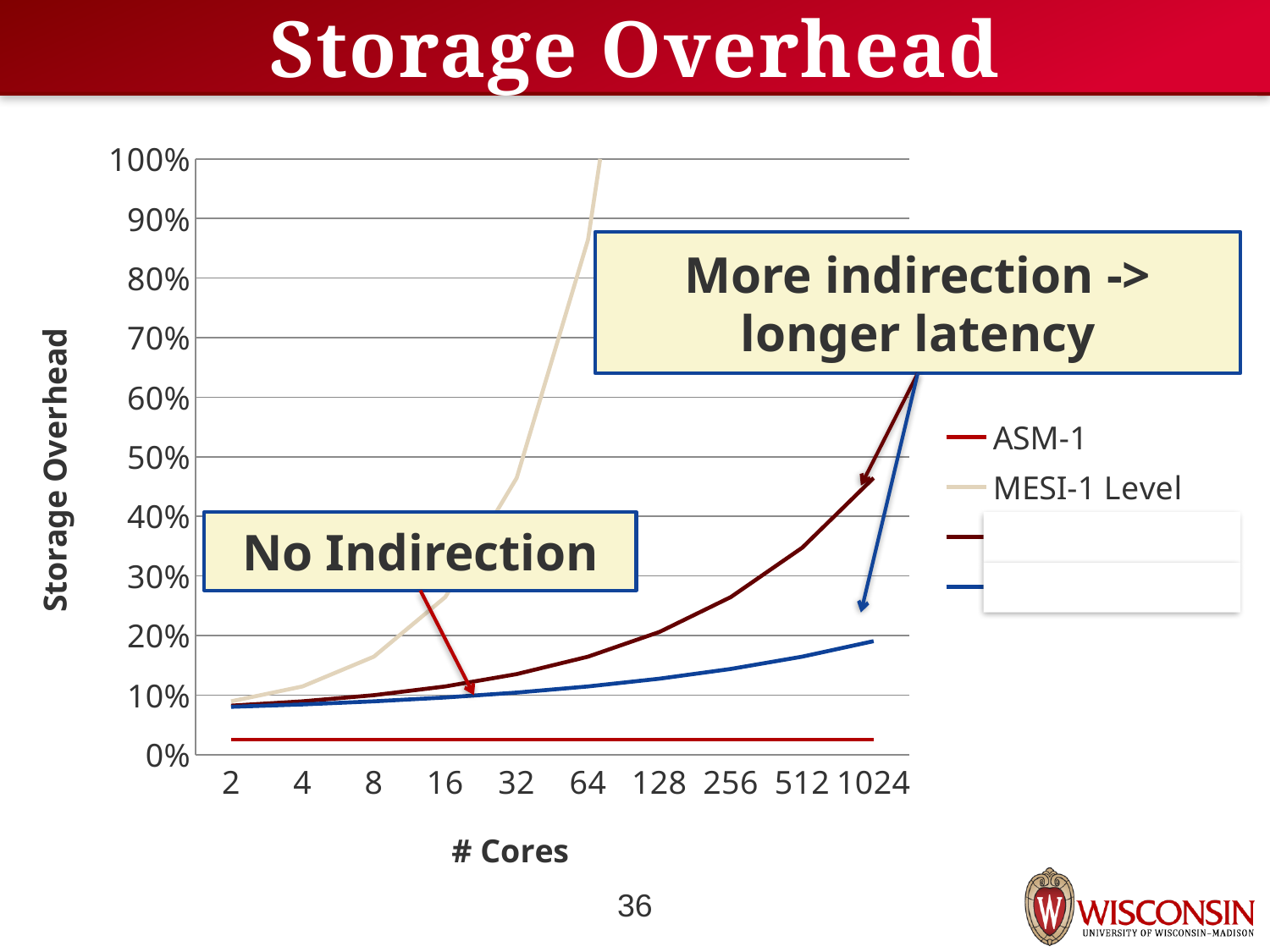
What is the title of the chart? Storage Overhead Does the MESI-1 Level series rise or fall as the number of cores increases? rise At 64 cores, which is larger: the value for MESI-1 Level or the value for ASM-1? MESI-1 Level Does the ASM-1 series rise, fall, or stay flat as the number of cores increases? stay flat Which series reaches the highest storage overhead on the chart? MESI-1 Level Is the value for MESI-1 Level at 8 cores greater or less than 10%? greater What kind of chart is shown on the slide? line chart How many core counts are marked along the x axis? 10 What is the label of the x axis? # Cores Which series has the lowest storage overhead across all core counts? ASM-1 Is the value for ASM-1 at 1024 cores greater or less than 10%? less